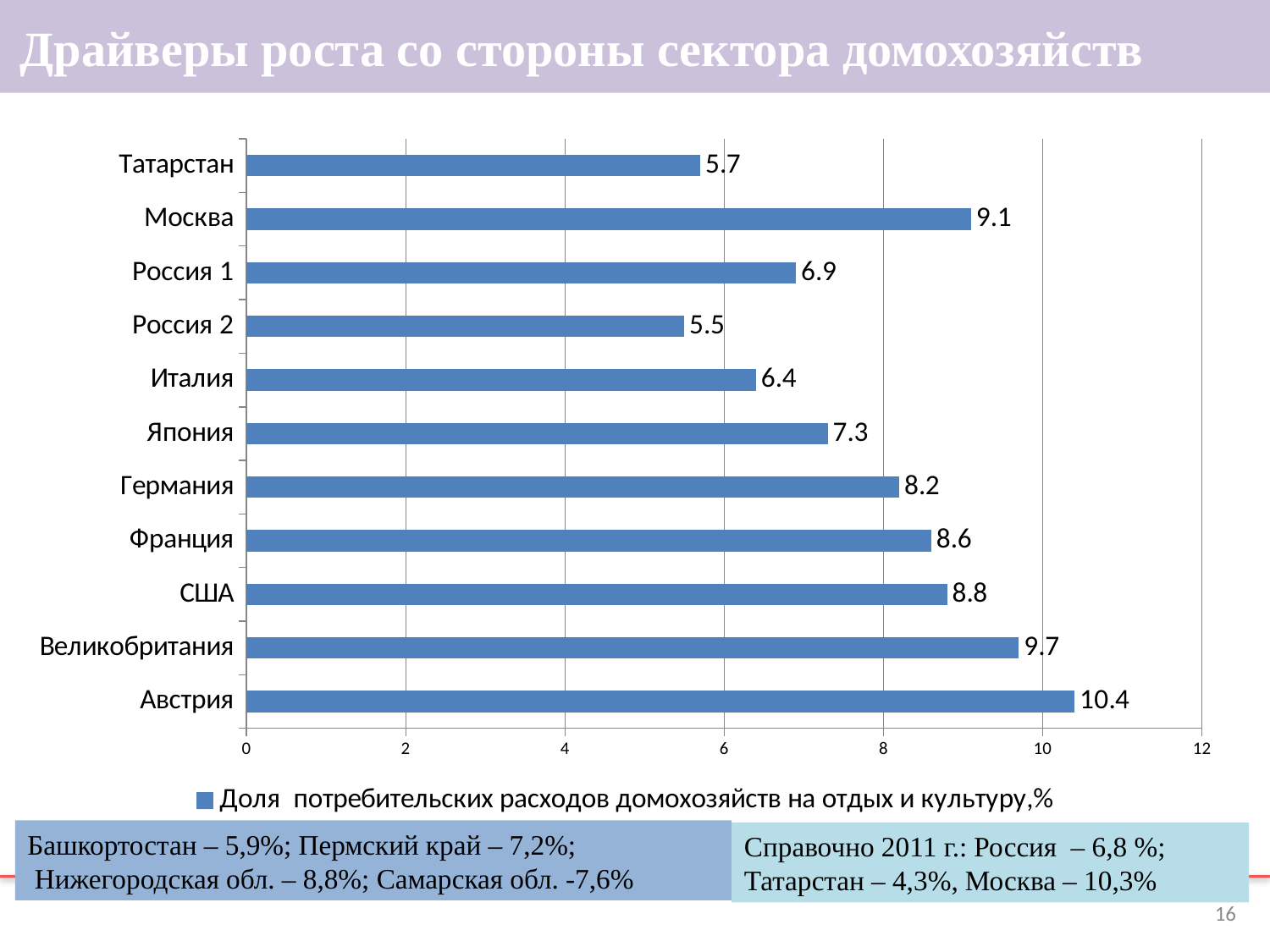
Which category has the highest value? Австрия What is the value for Москва? 9.1 What is the value for Австрия? 10.4 What kind of chart is shown on the slide? Bar chart What is the legend entry of the chart? Доля потребительских расходов домохозяйств на отдых и культуру,% How many series does the legend list? 1 What is the value for Япония? 7.3 What is the difference between the values for США and Франция? 0.2 Which category has the lowest value? Россия 2 What is the difference between the values for Великобритания and Татарстан? 4 Which is larger, the value for Германия or the value for Италия? Германия How many categories are shown in the chart? 11